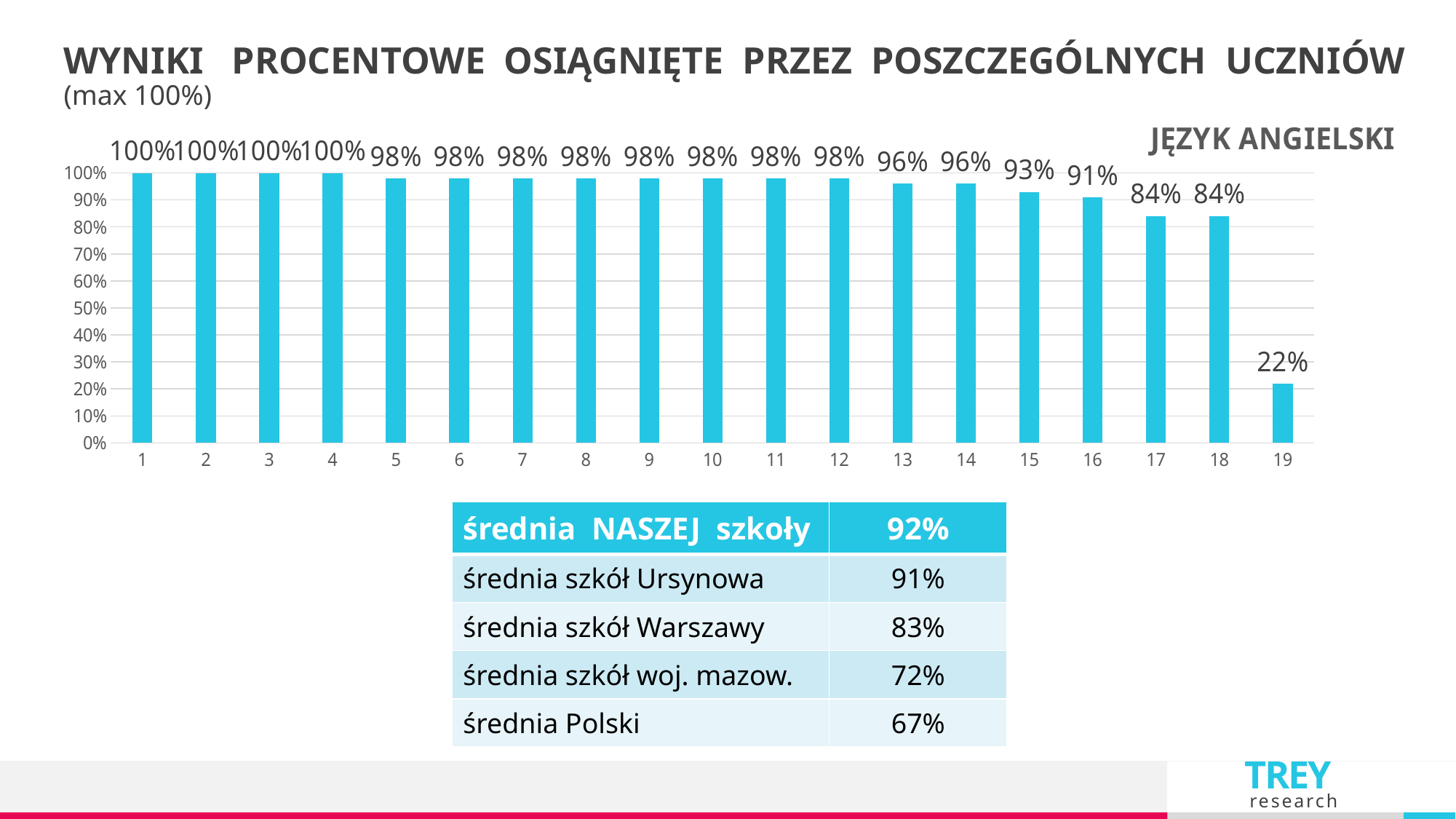
Do the values rise or fall from student 1 to student 19? fall Which student has the lowest result? 19 How many students are shown on the x axis? 19 Is the value for student 19 greater or less than 30%? less What subject label appears in the top right corner of the chart? JĘZYK ANGIELSKI Which is larger, the value for student 14 or the value for student 18? student 14 What is the value for student 19? 22% What is the value for student 13? 96% What is the difference between the values for student 16 and student 19? 69% What kind of chart is shown on the slide? bar chart What is the value for student 15? 93% What is the difference between the values for student 1 and student 17? 16%